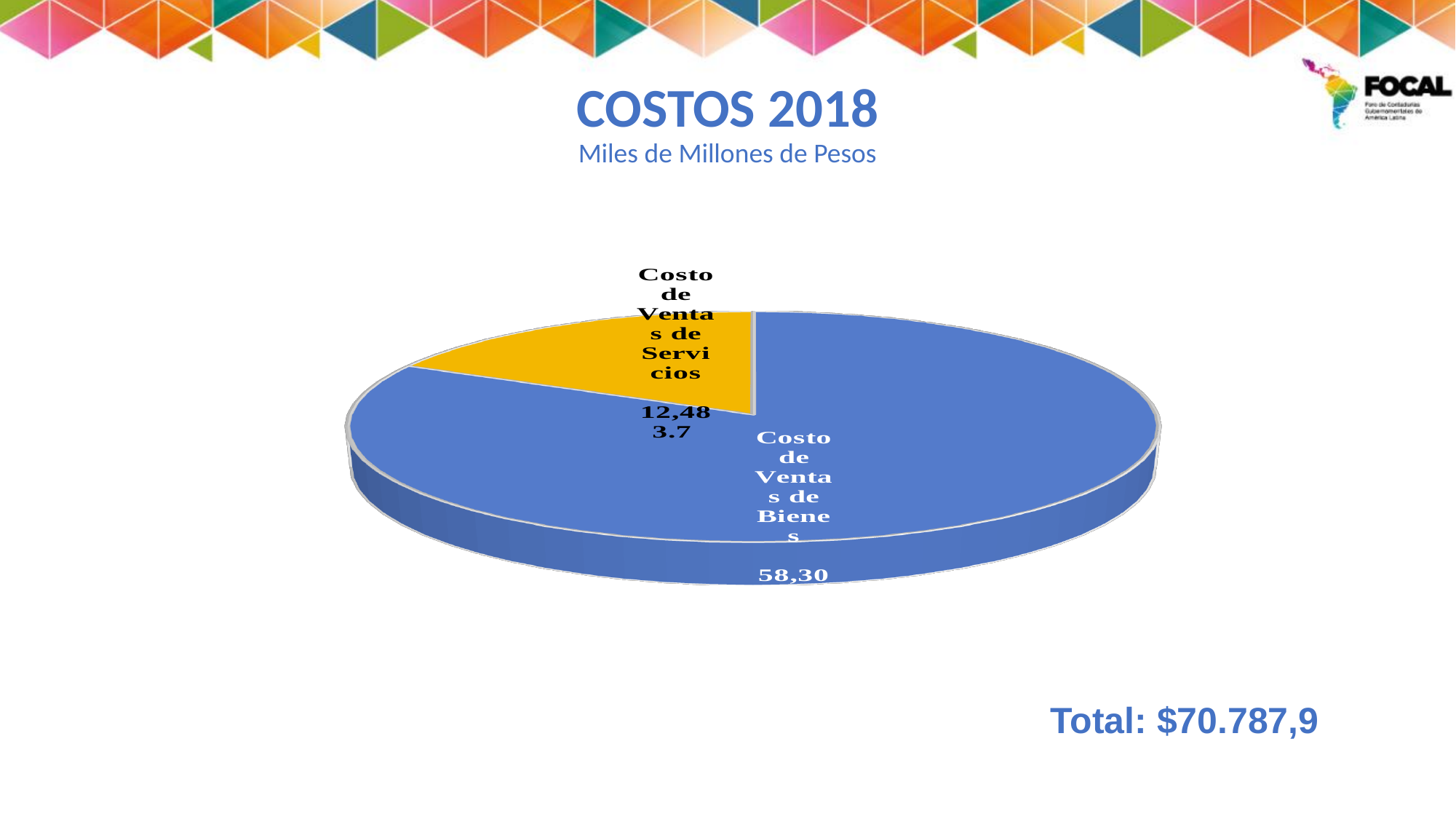
What is the value shown for Costo de Ventas de Servicios? 12,483.7 How many slices does the pie chart have? 2 What kind of chart is shown on the slide? pie chart Which category has the largest slice of the pie chart? Costo de Ventas de Bienes Which is larger, Costo de Ventas de Bienes or Costo de Ventas de Servicios? Costo de Ventas de Bienes What colour is the Costo de Ventas de Bienes slice? blue What total is stated on the slide for the costs? $70.787,9 Which category has the smallest slice of the pie chart? Costo de Ventas de Servicios What is the title of the chart on the slide? COSTOS 2018